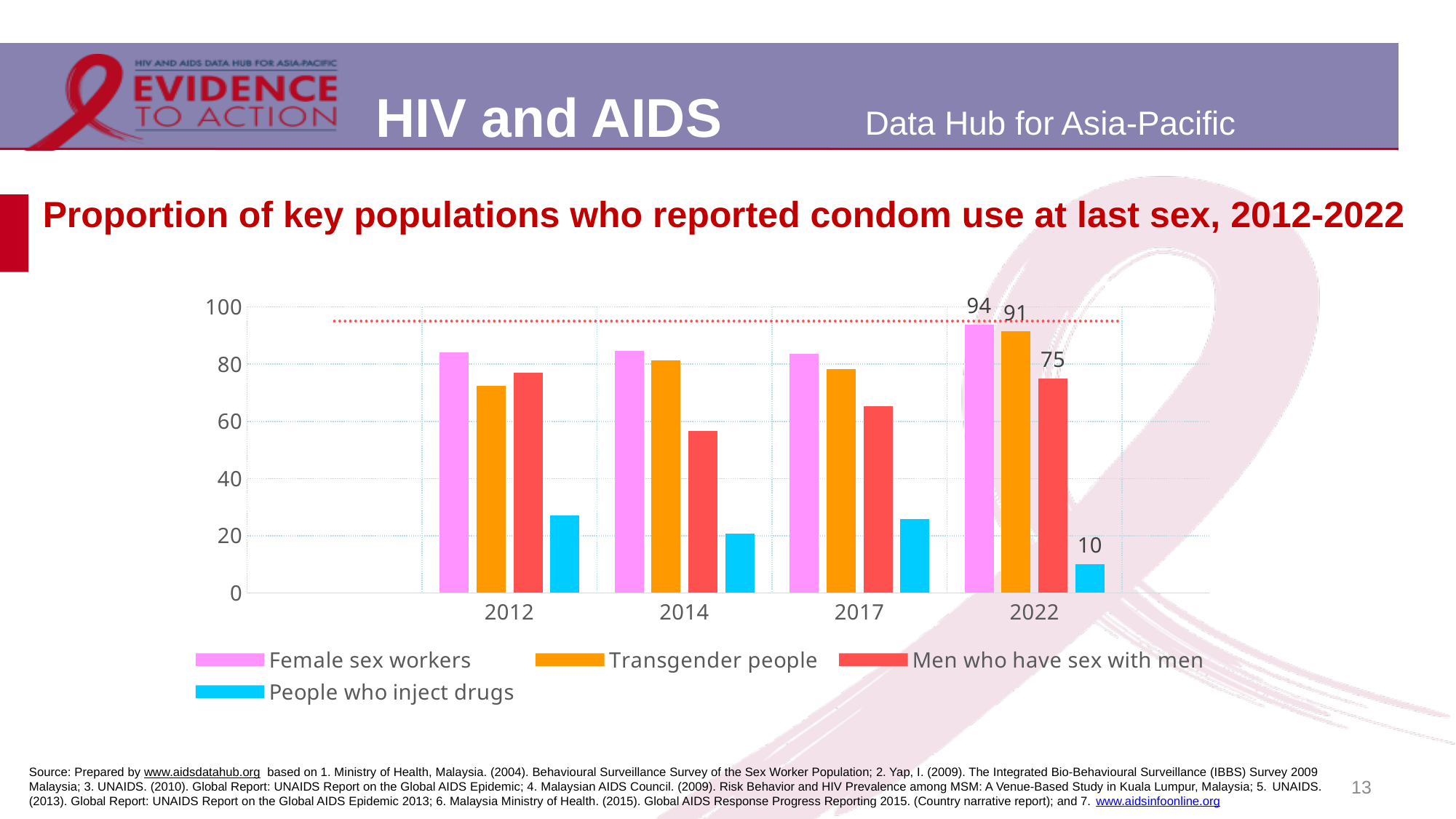
What is the value for Transgender people in 2022? 91 Which key population has the highest value in 2022? Female sex workers How many years are shown on the x axis? 4 What is the difference between the 2022 values for Transgender people and Men who have sex with men? 16 How many series does the legend list? 4 What is the difference between the 2022 values for Female sex workers and People who inject drugs? 84 Which key population has the lowest value in 2022? People who inject drugs What is the value for Men who have sex with men in 2022? 75 What is the value for People who inject drugs in 2022? 10 What is the value for Female sex workers in 2022? 94 Is the value for Transgender people in 2012 greater or less than 60? greater Is the value for People who inject drugs in 2012 greater or less than 40? less